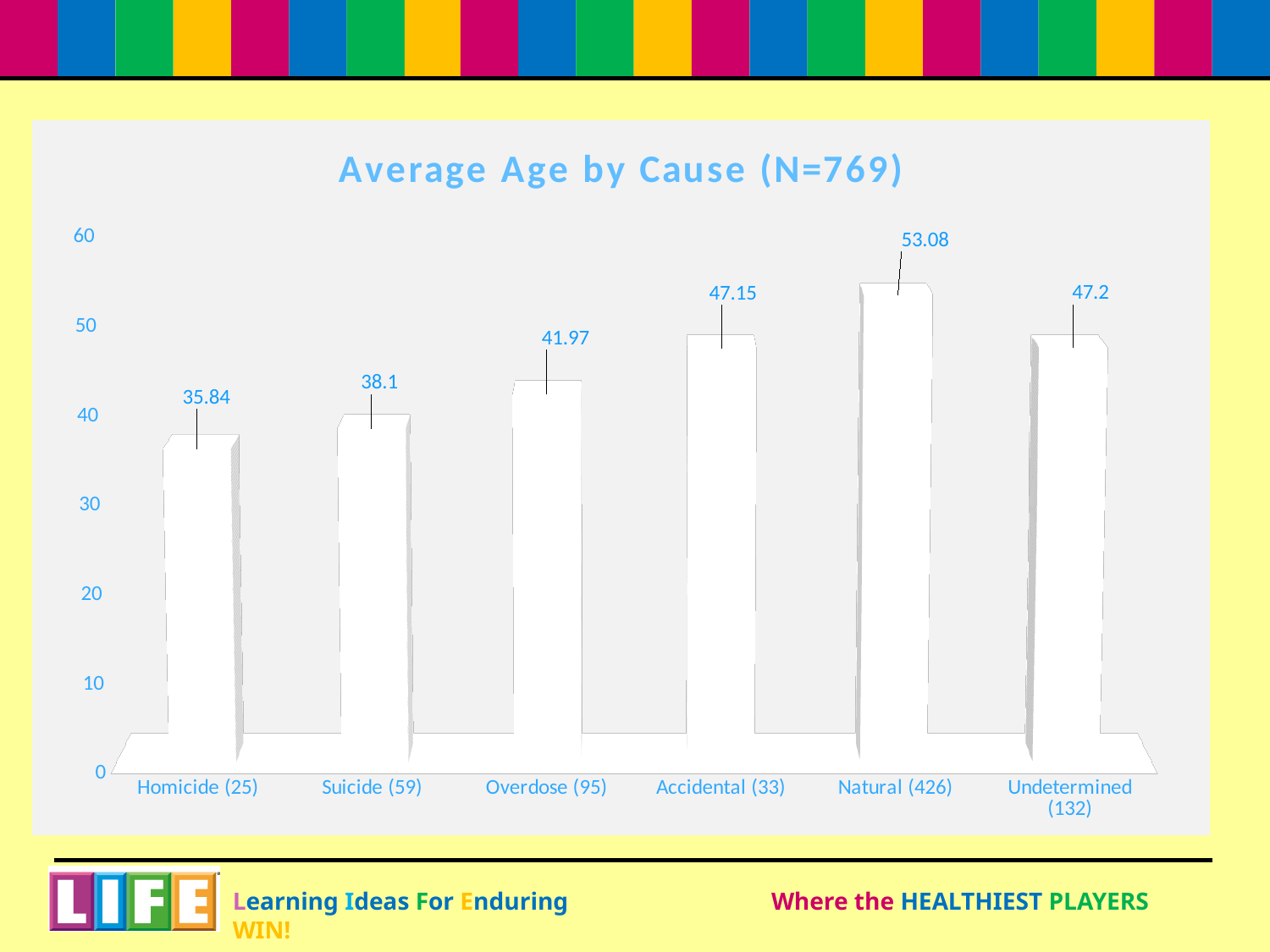
Which cause has the highest average age? Natural (426) What is the average age for Homicide (25)? 35.84 Is the value for Undetermined (132) greater or less than 40? greater What is the average age for Natural (426)? 53.08 Which cause has the lowest average age? Homicide (25) What is the title of the chart? Average Age by Cause (N=769) What kind of chart is shown on the slide? bar chart Which has a higher average age, Accidental (33) or Suicide (59)? Accidental (33) What is the difference between the average age for Natural (426) and Homicide (25)? 17.24 How many causes are shown on the chart? 6 What is the difference between the average age for Overdose (95) and Suicide (59)? 3.87 What is the average age for Overdose (95)? 41.97